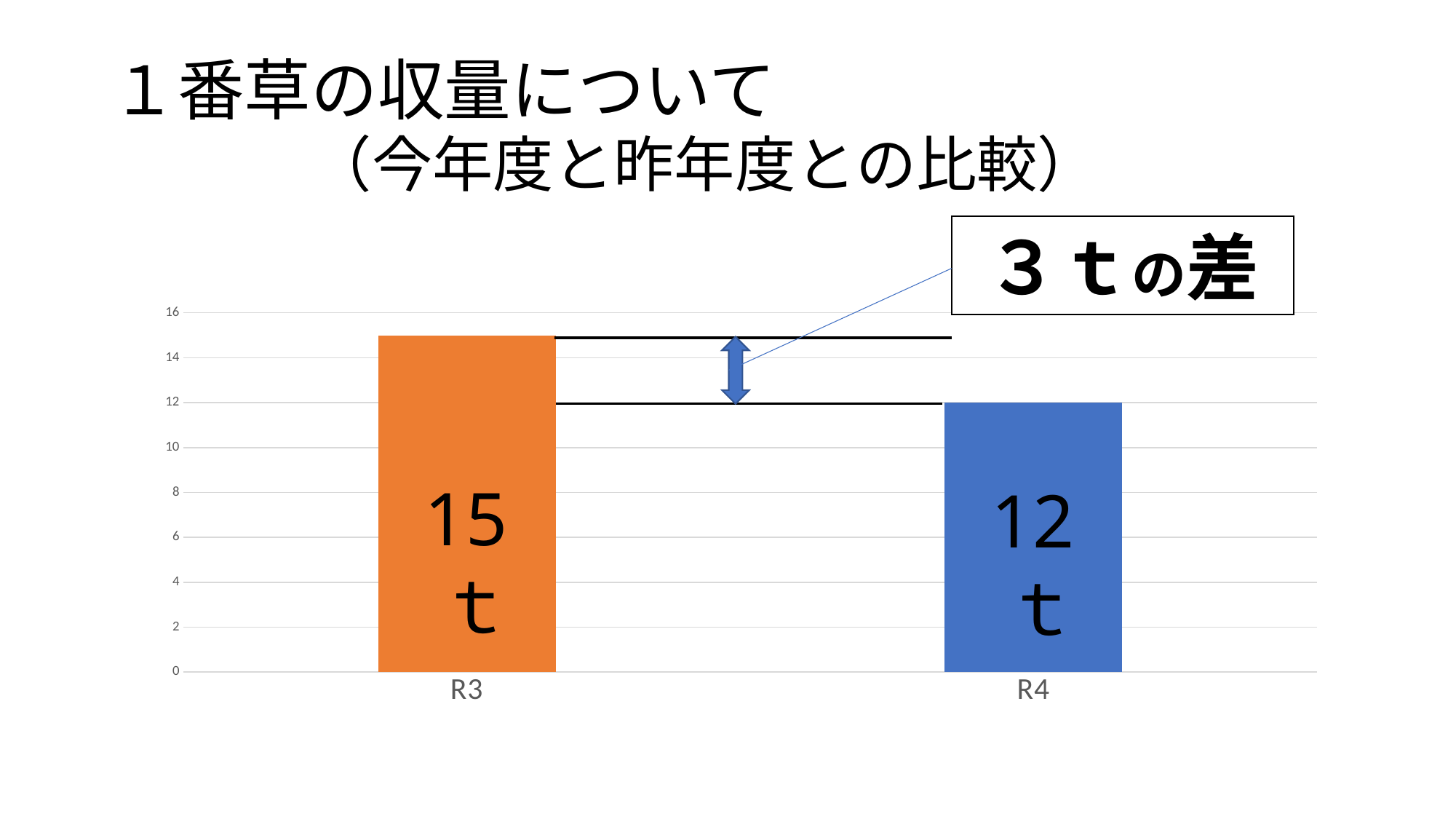
Which category has the highest value? R3 How many categories are shown on the x axis? 2 What is the value for R4? 12 t Do the values rise or fall from R3 to R4? fall Which is larger, the value for R3 or the value for R4? R3 Is the value for R3 greater or less than 14? greater What colour is the bar for R3? orange Is the value for R4 greater or less than 14? less What kind of chart is shown on the slide? bar chart Which category has the lowest value? R4 What is the value for R3? 15 t What is the difference between the values for R3 and R4? 3 t